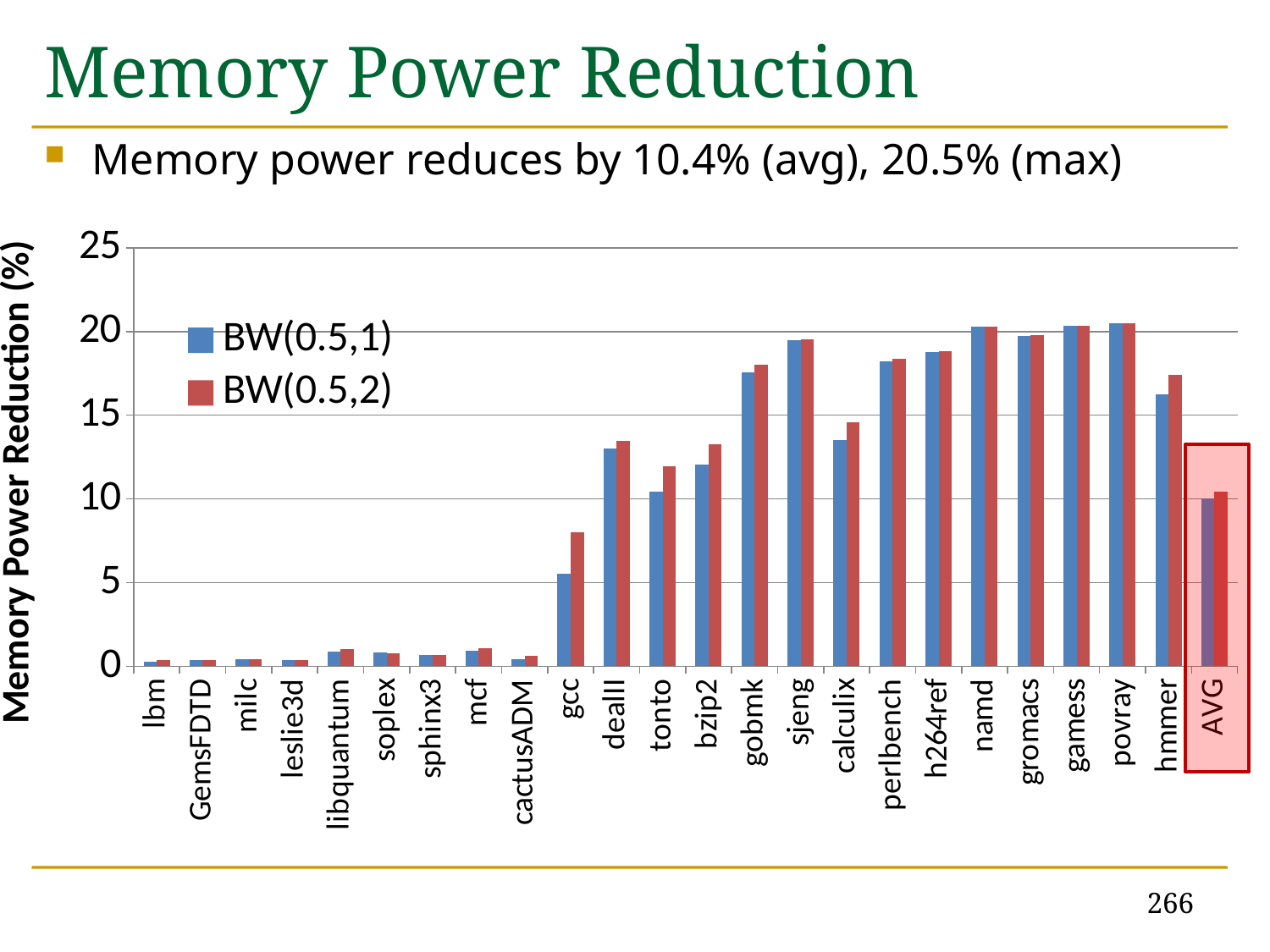
For gcc, which series has the larger value, BW(0.5,1) or BW(0.5,2)? BW(0.5,2) Is the BW(0.5,1) value for dealII greater or less than 15? less How many categories are shown along the x axis, including AVG? 24 Do the bar values generally rise or fall moving from left to right across the benchmarks? rise What are the two series named in the legend? BW(0.5,1) and BW(0.5,2) Is the BW(0.5,2) value for sjeng greater or less than 15? greater How many series does the chart's legend list? 2 What is the title of the y axis? Memory Power Reduction (%) Which has the larger BW(0.5,1) value, gcc or dealII? dealII Is the BW(0.5,1) value for gcc greater or less than 10? less What kind of chart is shown on the slide? bar chart